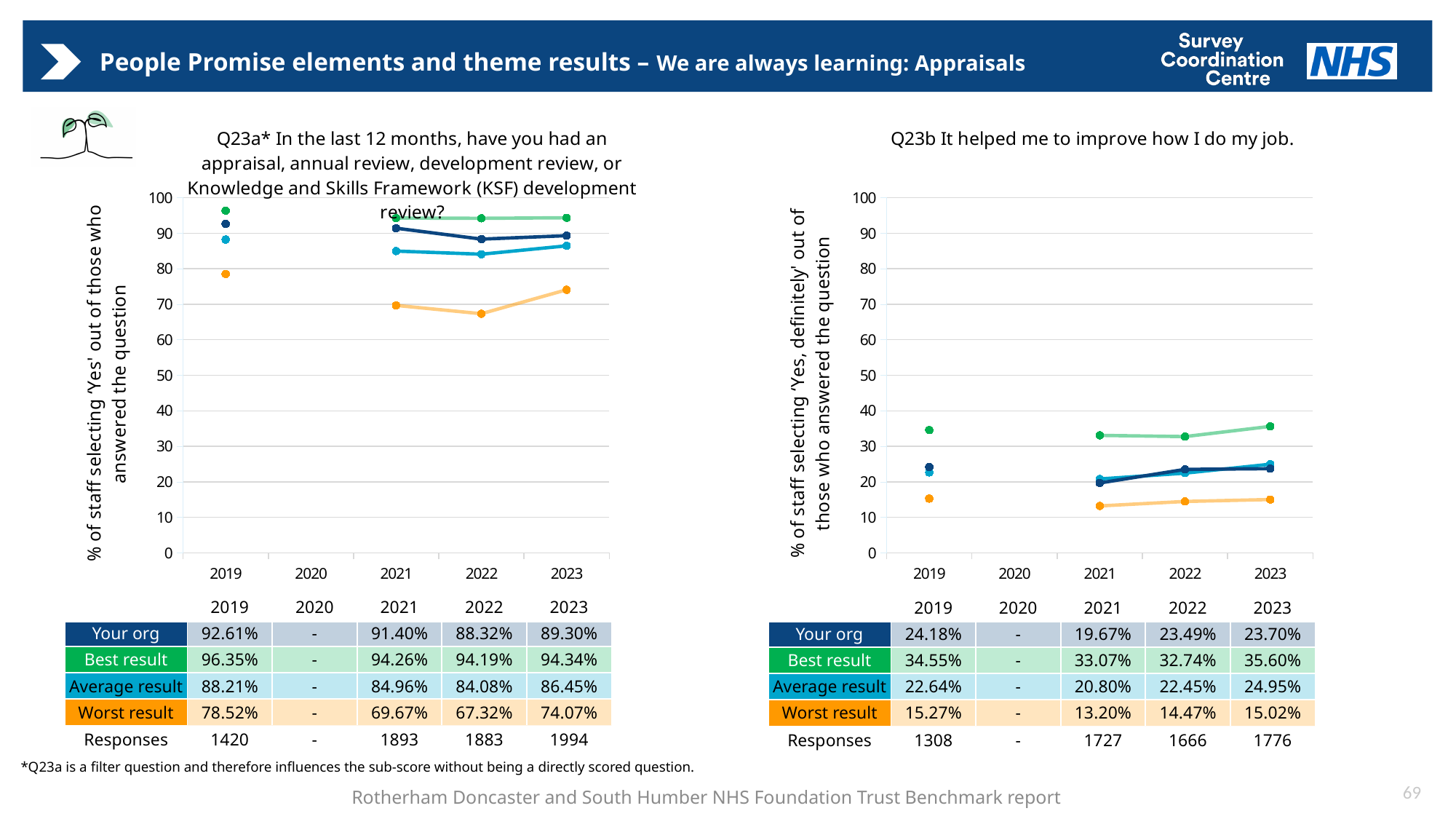
In the Q23a chart, in which year is the Worst result value highest? 2019 In the Q23b chart, does the Worst result value rise or fall from 2021 to 2023? rise In the Q23b chart, which is larger for 2023: the Average result or the Your org value? Average result In the Q23a chart, is the Worst result value for 2022 greater or less than 70? less In the Q23b chart, what is the difference between the Your org values for 2019 and 2023? 0.48 percentage points In the Q23a chart, what is the difference between the Best result and Your org values for 2022? 5.87 percentage points In the Q23b chart, how many years have plotted data points? 4 In the Q23a table, how many responses were there in 2023? 1994 In the Q23b chart, what is the Best result value for 2021? 33.07% In the Q23b chart, in which year is the Your org value lowest? 2021 What kind of chart is the Q23a chart? line chart In the Q23a chart, what is the Your org value for 2023? 89.30%